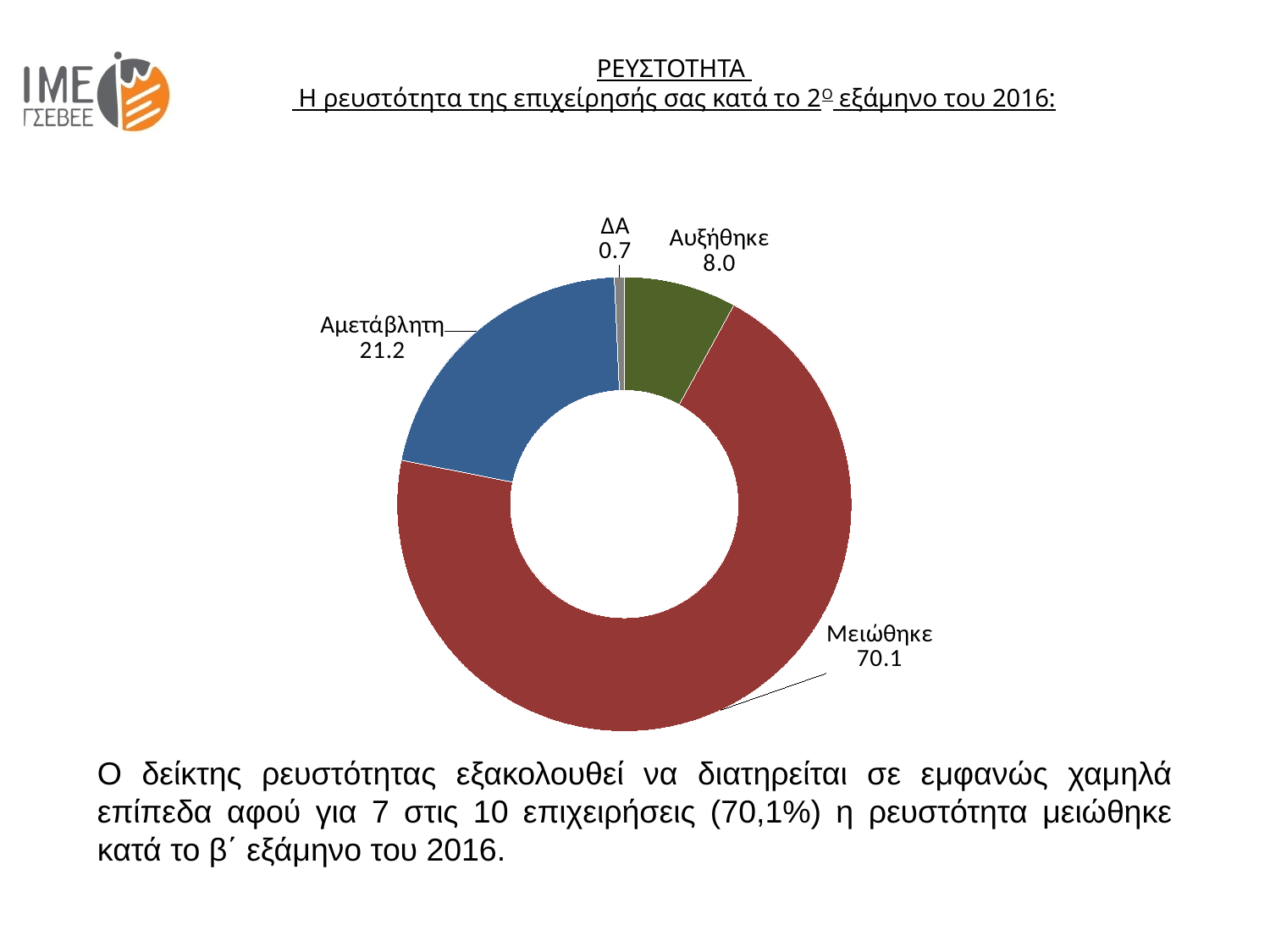
What is the difference between the values for Μειώθηκε and Αμετάβλητη? 48.9 Which is larger, Αμετάβλητη or Αυξήθηκε? Αμετάβλητη Which category has the smallest slice? ΔΑ What kind of chart is shown on the slide? Pie (doughnut) chart How many categories are shown in the chart? 4 What value is shown for Αυξήθηκε? 8.0 What value is shown for Αμετάβλητη? 21.2 What value is shown for ΔΑ? 0.7 What colour is the Μειώθηκε slice? Red Which category has the largest slice? Μειώθηκε What is the difference between the values for Αμετάβλητη and Αυξήθηκε? 13.2 What value is shown for Μειώθηκε? 70.1